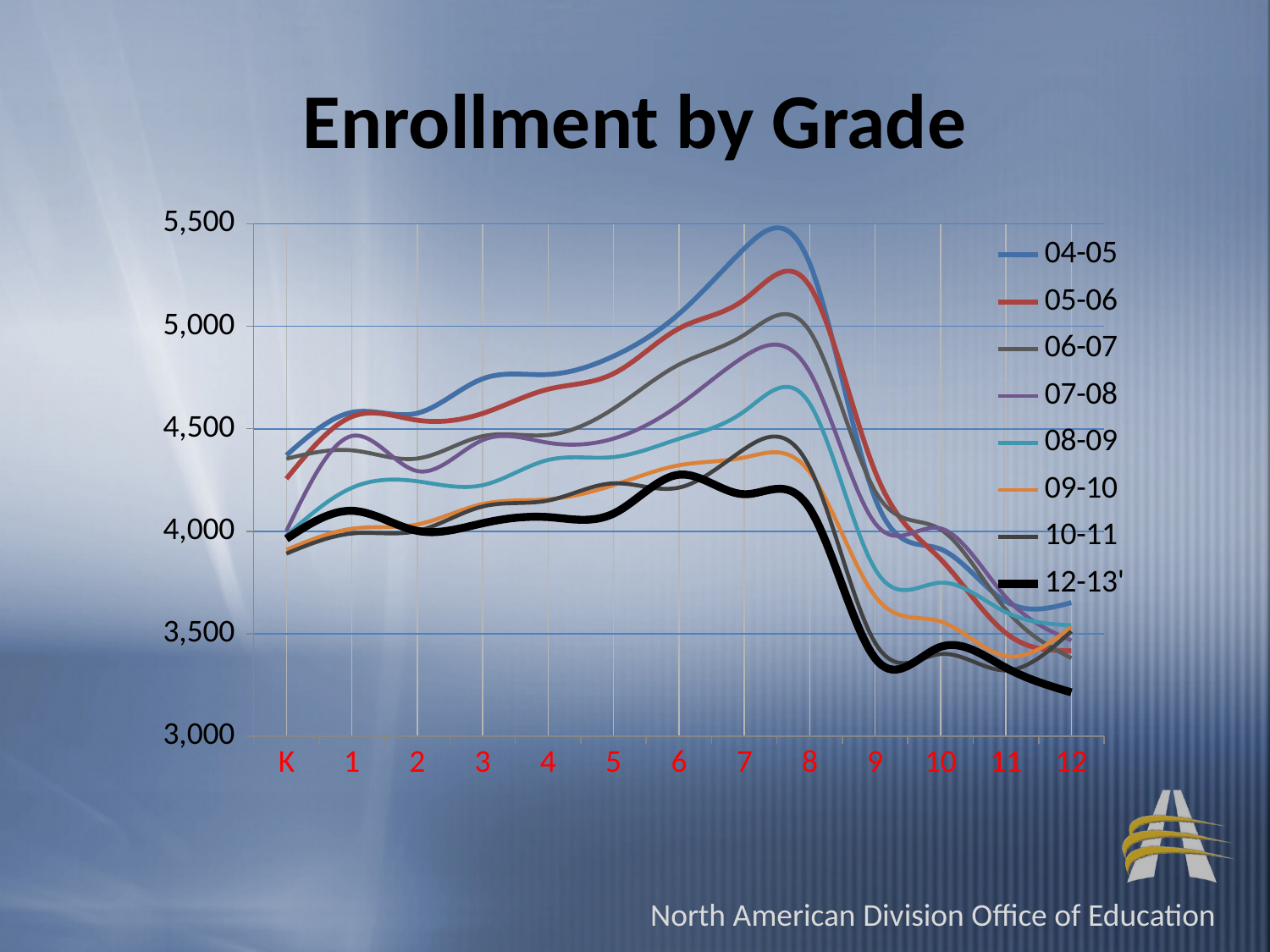
What kind of chart is shown on the slide? line chart Which series has the lowest value at grade 12? 12-13' How many grade categories are shown on the x axis? 13 Do the values for the series rise or fall from grade 8 to grade 9? fall What is the title of the chart? Enrollment by Grade At grade 12, which is larger: the value for 04-05 or the value for 12-13'? 04-05 Is the value for 04-05 at grade 8 greater or less than 5,000? greater How many series does the legend list? 8 Is the value for 08-09 at grade 8 greater or less than 5,000? less Which series has the highest value at grade 8? 04-05 Is the value for 12-13' at grade 6 greater or less than 4,000? greater